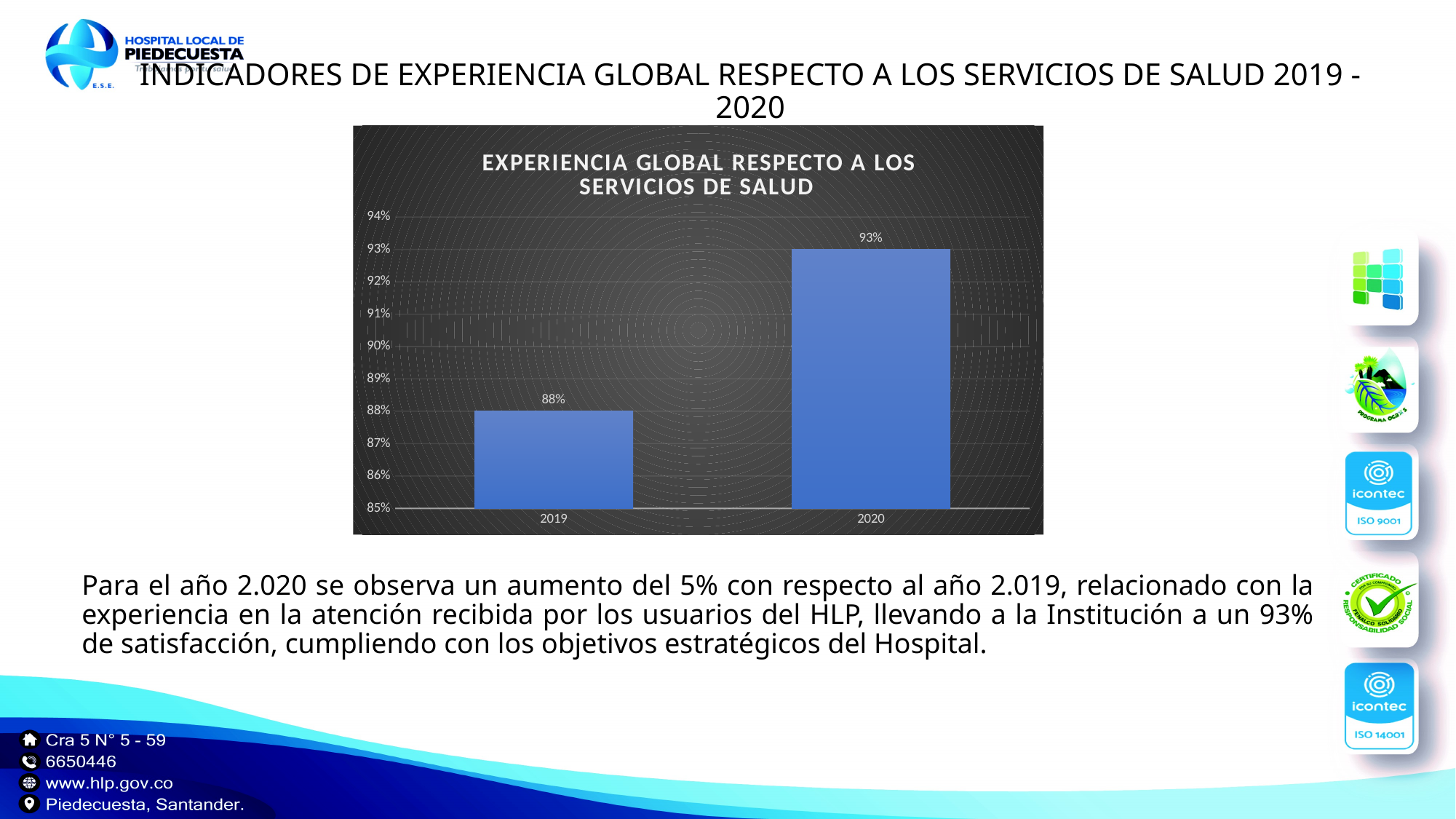
What is the value for 2020? 93% What is the difference between the values for 2020 and 2019? 5% What is the title of the chart? EXPERIENCIA GLOBAL RESPECTO A LOS SERVICIOS DE SALUD What is the value for 2019? 88% Do the values rise or fall from 2019 to 2020? rise Is the value for 2019 greater or less than 90%? less What kind of chart is shown? bar chart How many categories are shown on the x axis? 2 Is the value for 2020 greater or less than 90%? greater Which year has the highest value? 2020 Which is larger, the value for 2019 or the value for 2020? 2020 Which year has the lowest value? 2019